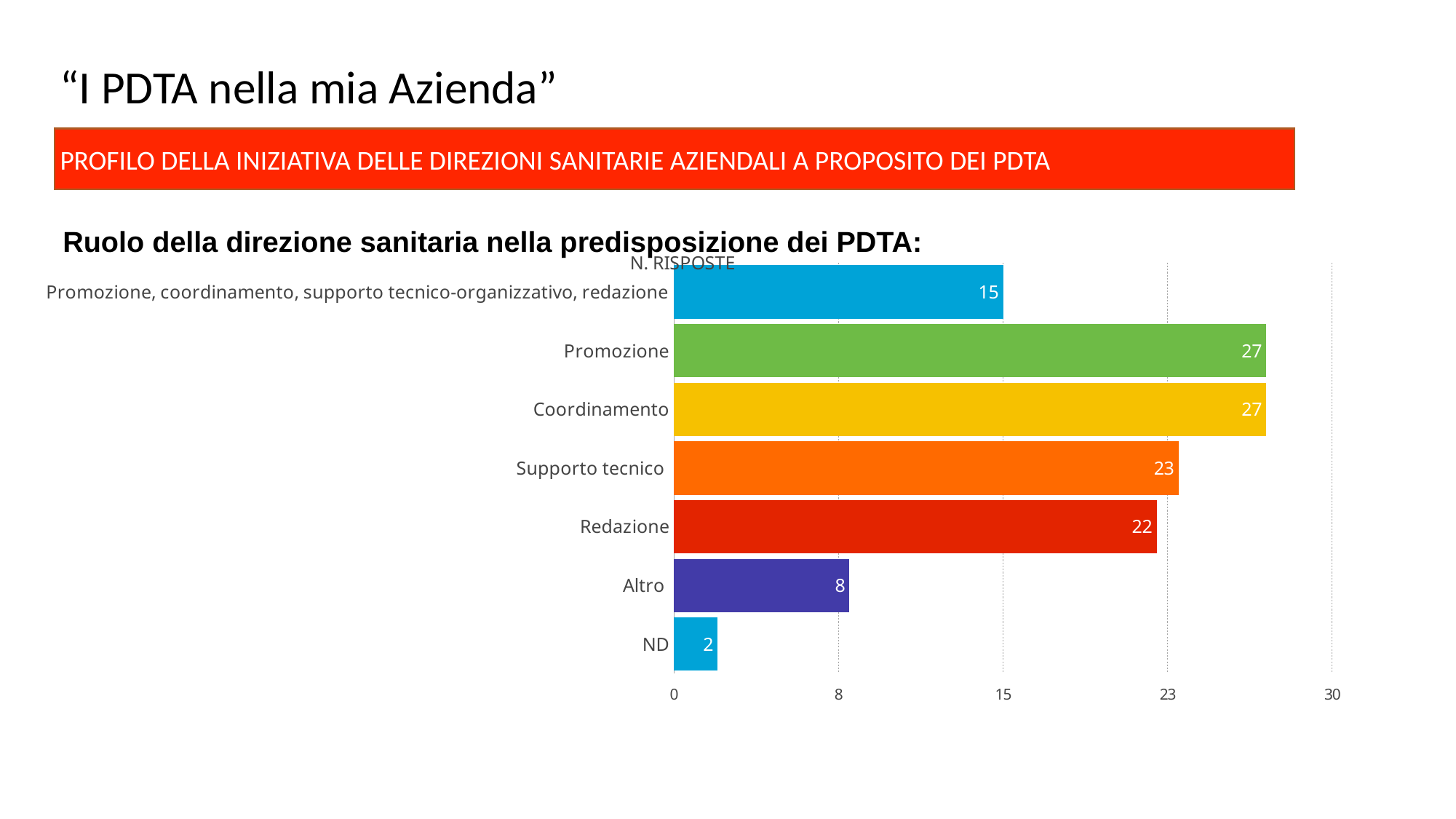
What is the difference between the values for Promozione and Altro? 19 What is the value for Redazione? 22 Which is larger, the value for Coordinamento or the value for Supporto tecnico? Coordinamento Is the value for Redazione greater or less than 15? greater What kind of chart is shown on the slide? bar chart What is the difference between the values for Supporto tecnico and Redazione? 1 What is the title of the chart? N. RISPOSTE What is the value for Altro? 8 Which category has the lowest value? ND What is the value for the category 'Promozione, coordinamento, supporto tecnico-organizzativo, redazione'? 15 How many categories are shown in the chart? 7 What is the value for Supporto tecnico? 23